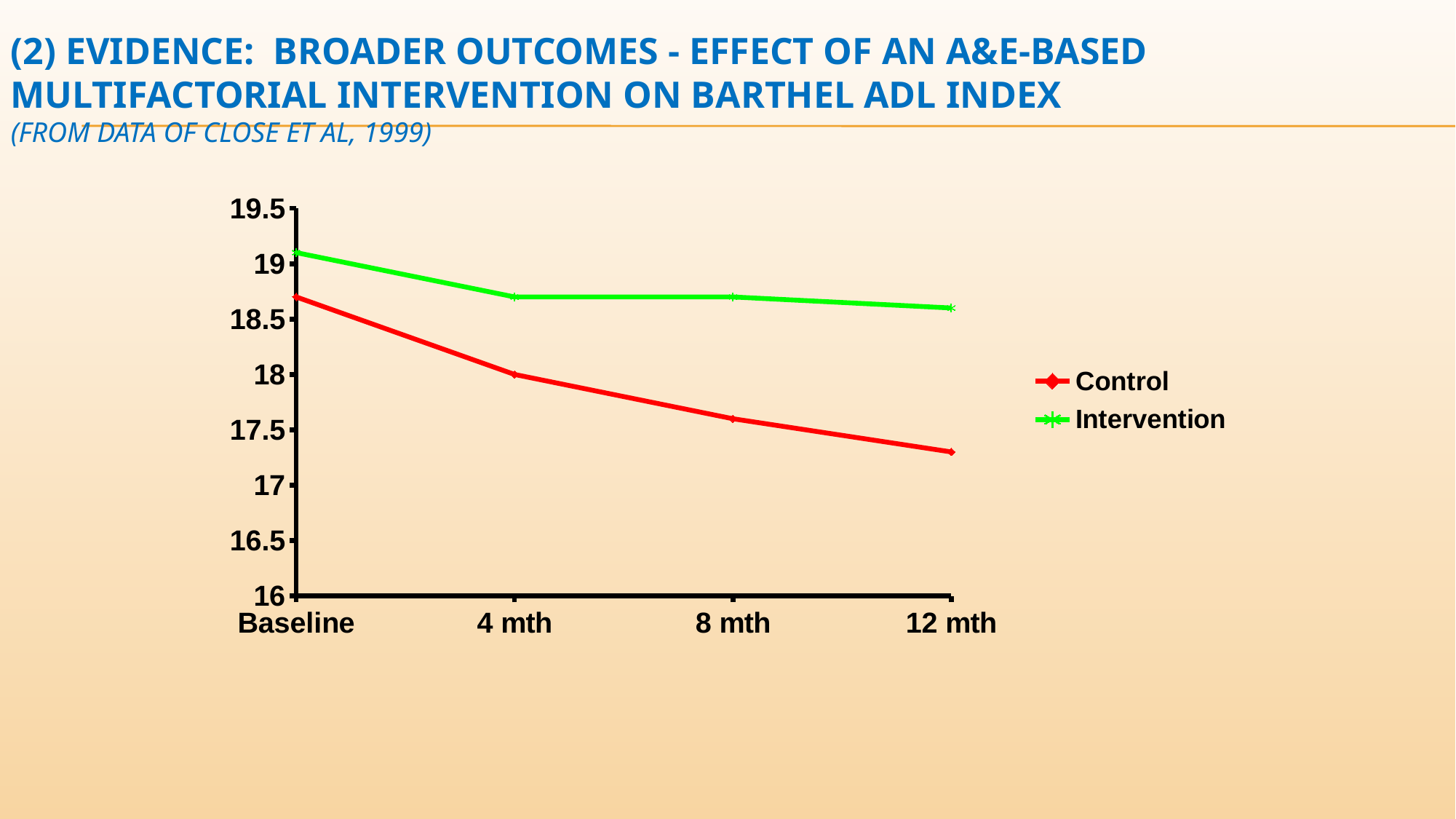
Is the value for Control at 8 mth greater or less than 18? less Is the value for Control at Baseline greater or less than 18.5? greater Is the value for Intervention at Baseline greater or less than 18.5? greater How many time points are shown on the x axis? 4 How many series does the legend list? 2 At 12 mth, which series has the higher value, Control or Intervention? Intervention What is the value for Control at 4 mth? 18 What kind of chart is shown on the slide? line chart Which series is drawn in green? Intervention Does the Control series rise or fall from Baseline to 12 mth? fall